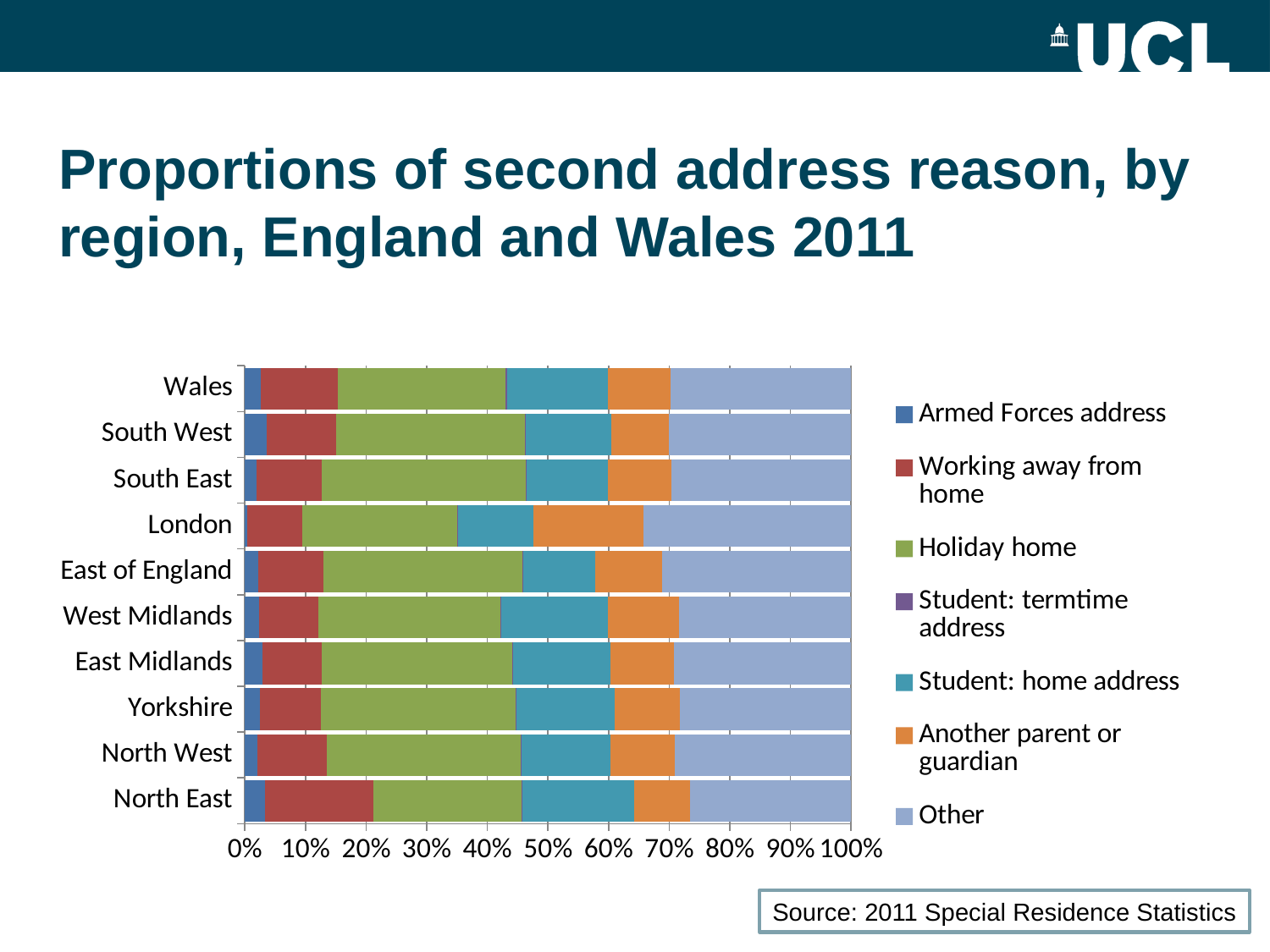
Is the 'Working away from home' share for North East greater or less than 10%? greater Which region has the largest share for 'Working away from home'? North East What is the title of the slide containing the chart? Proportions of second address reason, by region, England and Wales 2011 Is the 'Other' share for London greater or less than 30%? greater How many regions are listed on the vertical axis of the chart? 10 What does each stacked bar in the chart total? 100% Which region has the largest share for 'Other'? London How many series does the chart legend list? 7 Which is larger: the 'Another parent or guardian' share for London or for Wales? London Which region has the largest share for 'Another parent or guardian'? London What kind of chart is shown on the slide? Stacked bar chart What source is cited for the chart data? 2011 Special Residence Statistics